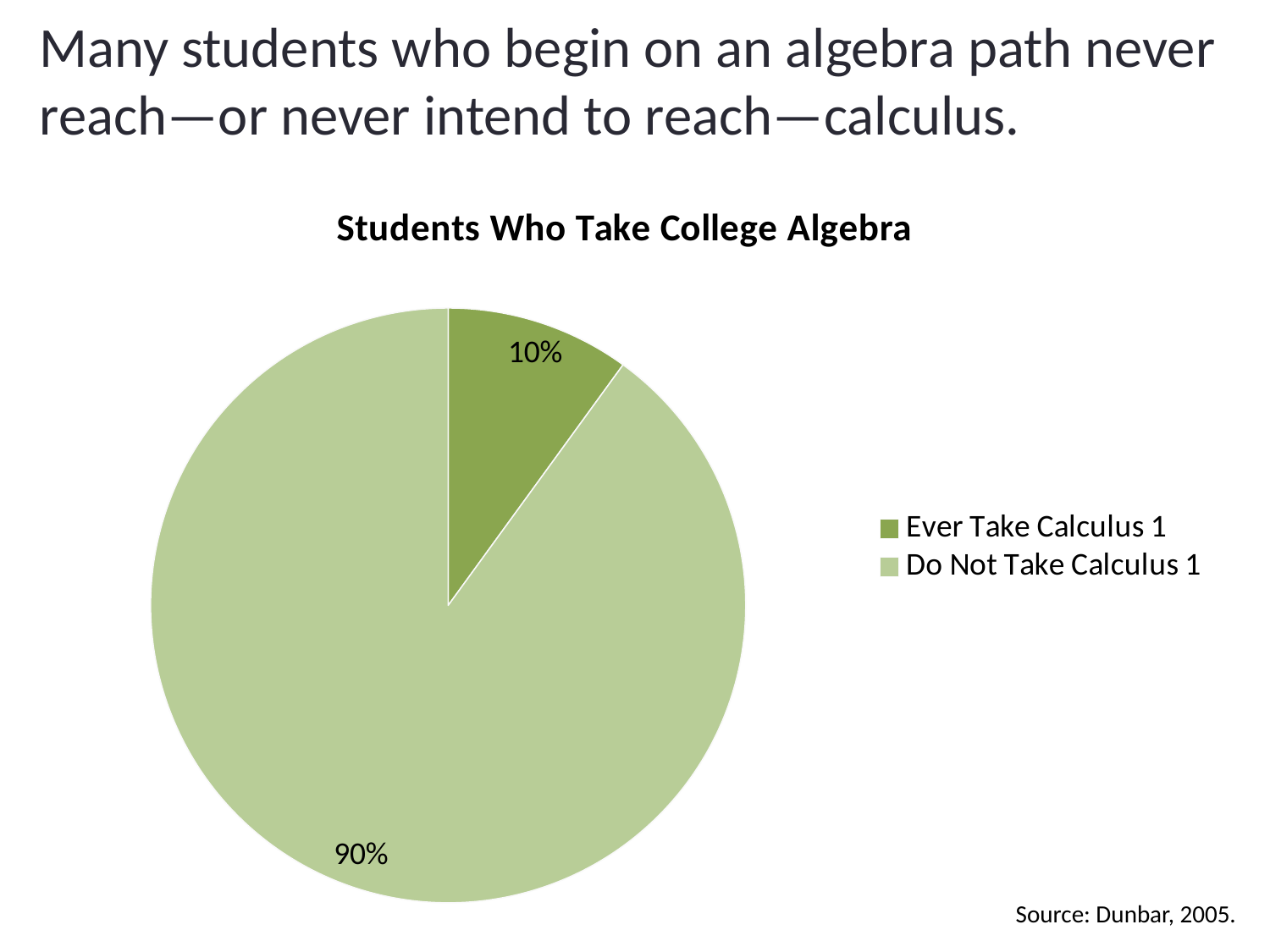
What is the difference in percentage points between the "Do Not Take Calculus 1" slice and the "Ever Take Calculus 1" slice? 80 percentage points Which is larger: the "Ever Take Calculus 1" slice or the "Do Not Take Calculus 1" slice? Do Not Take Calculus 1 What share of the pie is labelled "Ever Take Calculus 1"? 10% What share of the pie is labelled "Do Not Take Calculus 1"? 90% What kind of chart is shown on the slide? pie chart What is the chart's title? Students Who Take College Algebra What is the source cited for the chart? Dunbar, 2005 Which slice is the smallest? Ever Take Calculus 1 Which slice is the largest? Do Not Take Calculus 1 How many slices does the pie chart have? 2 How many entries does the legend list? 2